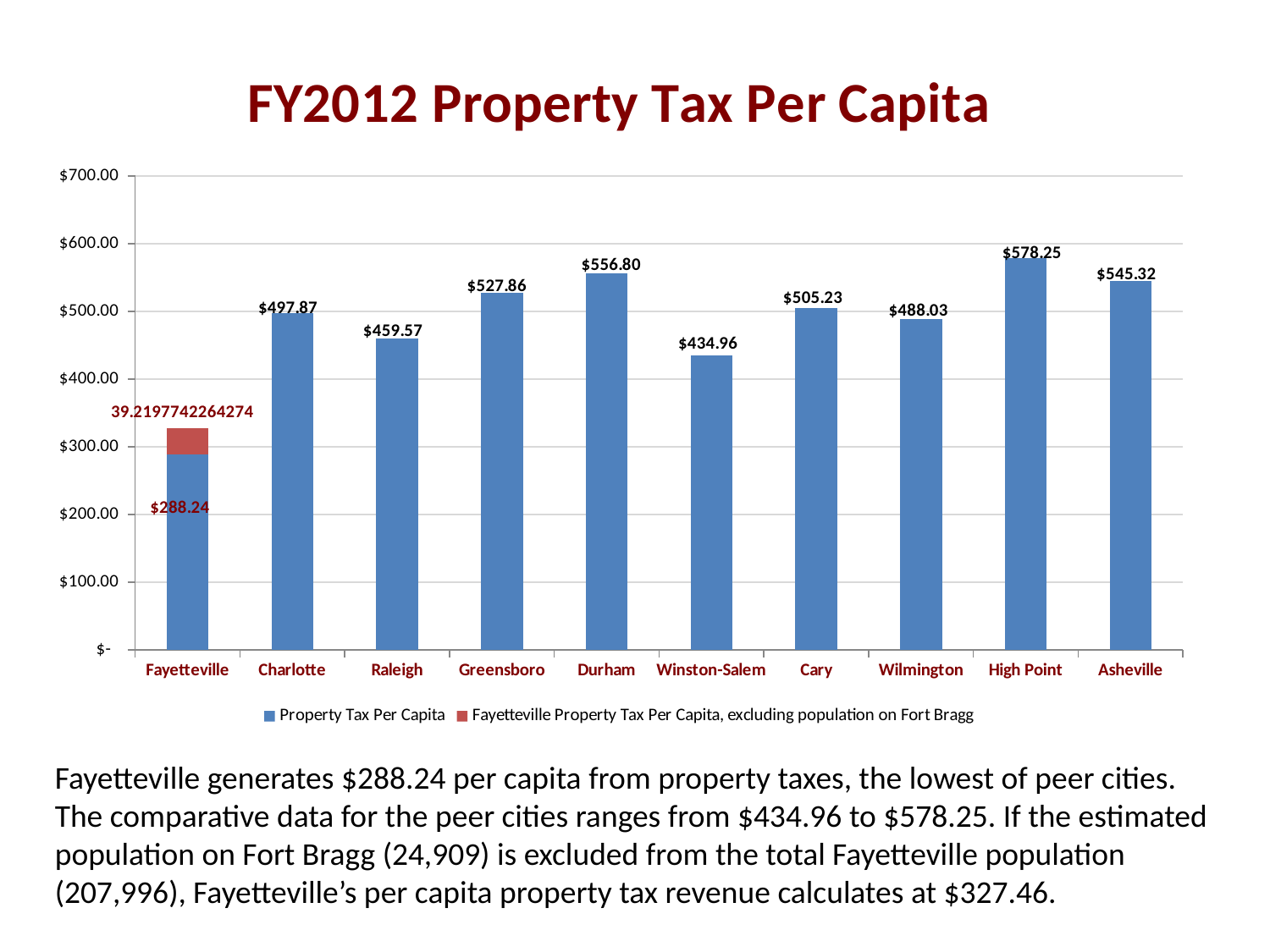
What kind of chart is shown on the slide? Bar chart What is the property tax per capita for Wilmington? $488.03 Which has a higher property tax per capita, Cary or Asheville? Asheville What is the difference between Durham's and Greensboro's property tax per capita? $28.94 How many cities are shown on the x axis? 10 What is the property tax per capita for Winston-Salem? $434.96 How many series does the legend list? 2 Which city has the lowest property tax per capita? Fayetteville Is the value for Raleigh greater or less than $500.00? less What is the title of the chart? FY2012 Property Tax Per Capita What is the property tax per capita for Charlotte? $497.87 Which city has the highest property tax per capita? High Point